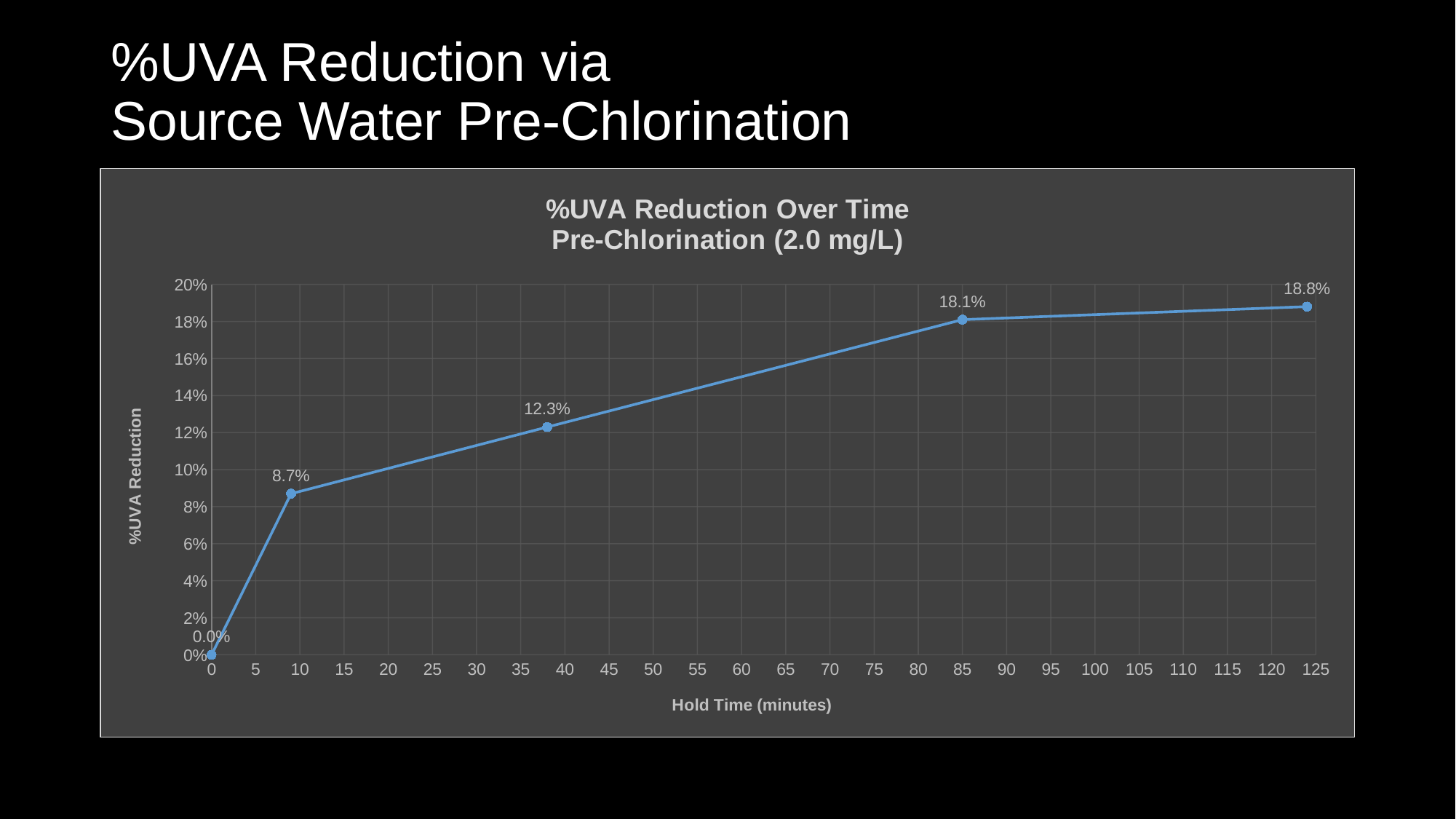
What kind of chart is shown on the slide? line chart What is the %UVA reduction at a hold time of 0 minutes? 0.0% What is the difference between the 12.3% point and the 8.7% point? 3.6% Is the hold time of the 18.1% data point greater or less than 80 minutes? greater What is the %UVA reduction value of the second data point on the chart? 8.7% How many data points are plotted on the chart? 5 What is the difference between the last two data labels, 18.8% and 18.1%? 0.7% Does the %UVA reduction rise or fall as hold time increases? rises Which is larger, the %UVA reduction at the third data point or at the fourth data point? the fourth data point (18.1%) What is the label on the x axis of the chart? Hold Time (minutes) What is the lowest %UVA reduction value shown on the chart? 0.0% What is the highest %UVA reduction value shown on the chart? 18.8%